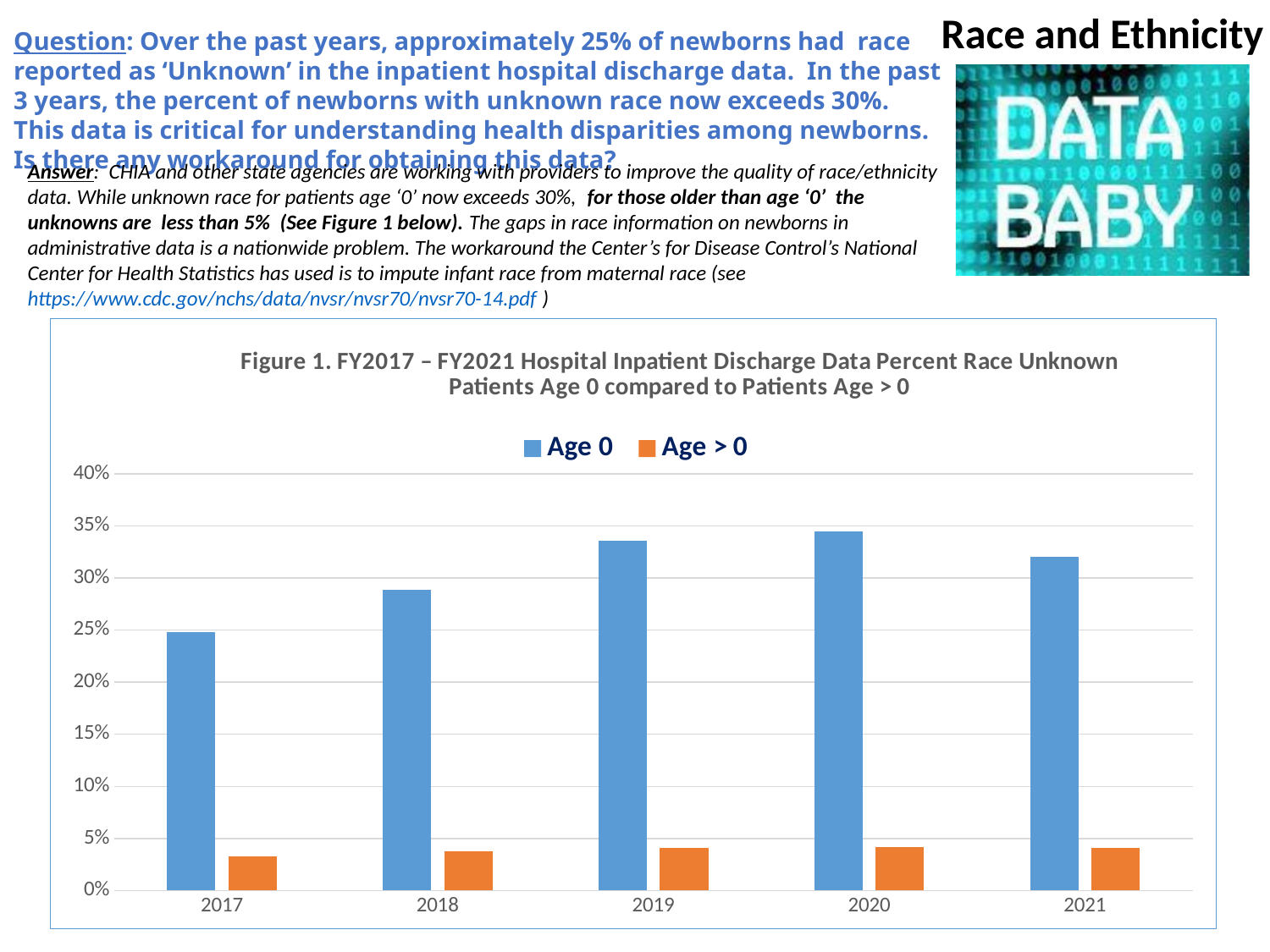
Is the Age 0 value for 2018 greater or less than 25%? greater Which year has the lowest Age 0 value in Figure 1? 2017 Is the Age 0 value for 2021 greater or less than 30%? greater How many series does the legend of Figure 1 list? 2 What kind of chart is shown in Figure 1? bar chart How many fiscal years are shown on the x axis of Figure 1? 5 Which is larger in Figure 1: the Age 0 value for 2018 or for 2019? 2019 From 2017 to 2020, do the Age 0 values in Figure 1 rise or fall? rise Is the Age > 0 value for 2020 greater or less than 5%? less Which colour represents the Age > 0 series in Figure 1? orange Which year has the highest Age 0 value in Figure 1? 2020